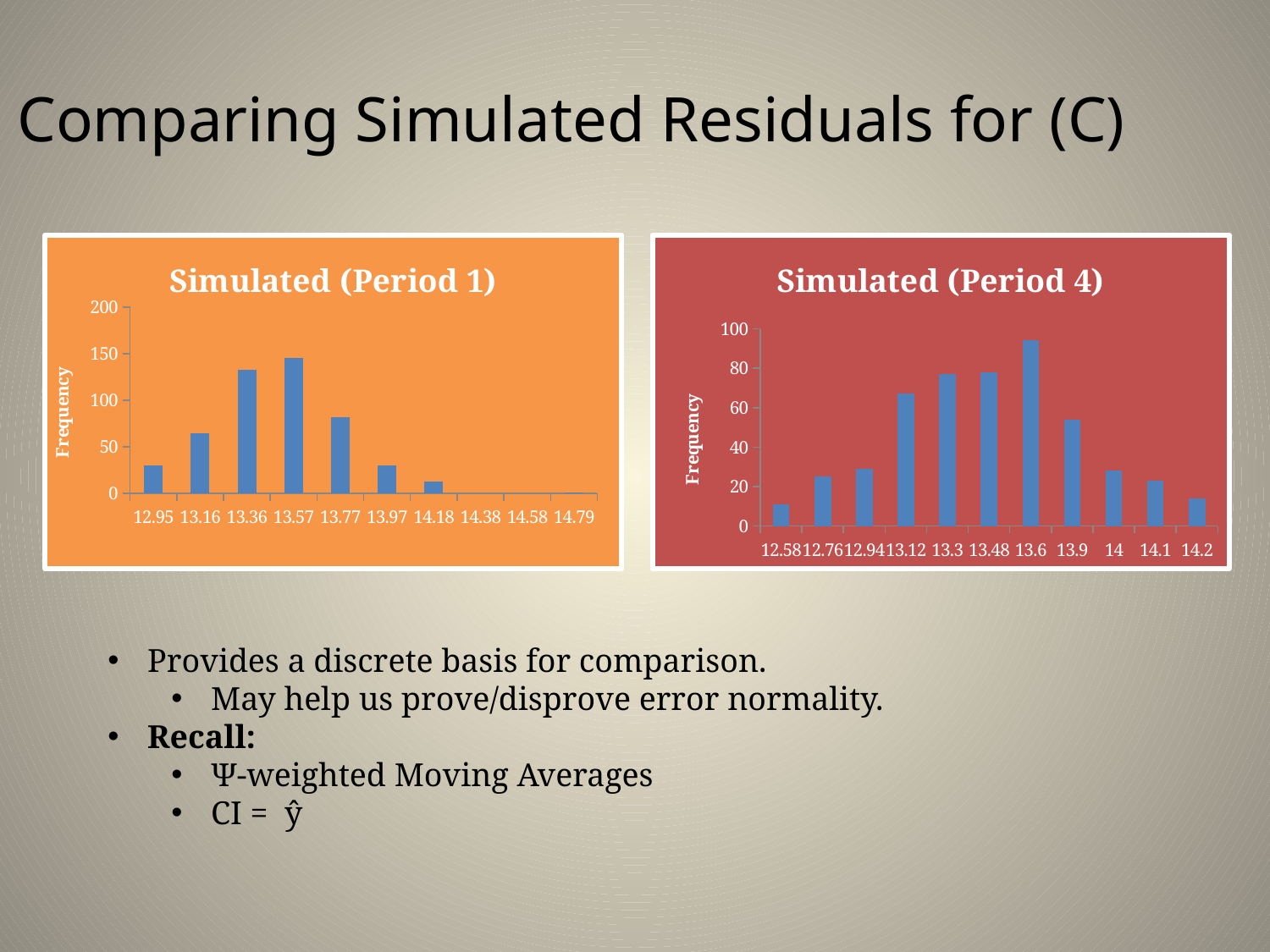
In the "Simulated (Period 4)" chart, which x-axis category has the highest frequency? 13.6 In the "Simulated (Period 1)" chart, is the frequency for 13.16 greater or less than 100? less How many x-axis categories are labelled in the "Simulated (Period 4)" chart? 11 In the "Simulated (Period 1)" chart, is the frequency for 13.36 greater or less than 100? greater In the "Simulated (Period 4)" chart, which has the higher frequency, 13.12 or 14? 13.12 In the "Simulated (Period 4)" chart, is the frequency for 12.58 greater or less than 20? less How many x-axis categories are labelled in the "Simulated (Period 1)" chart? 10 In the "Simulated (Period 1)" chart, which x-axis category has the highest frequency? 13.57 What is the y-axis label of the "Simulated (Period 4)" chart? Frequency What kind of chart is "Simulated (Period 1)"? bar chart In the "Simulated (Period 1)" chart, which has the higher frequency, 13.77 or 13.97? 13.77